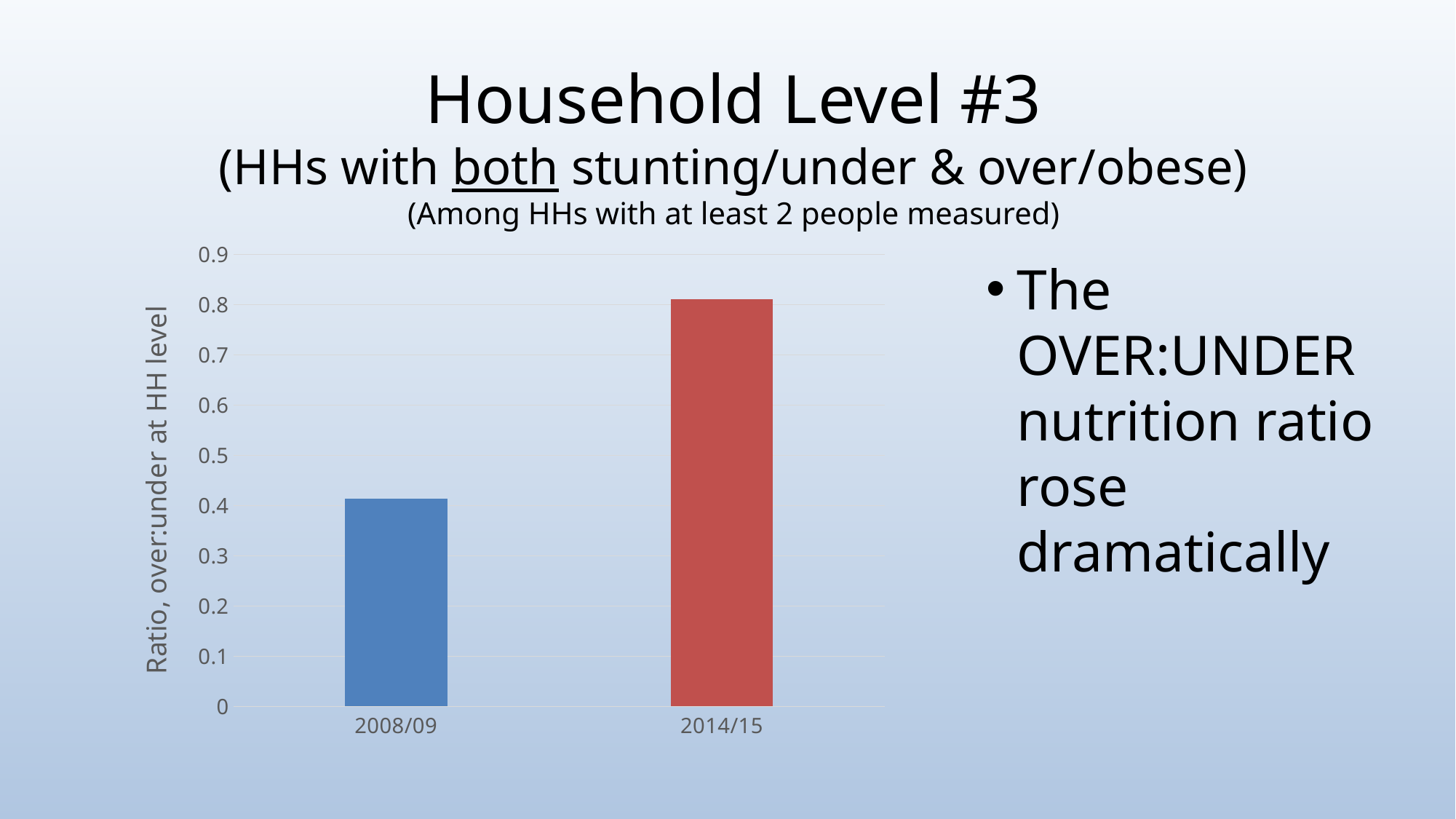
What colour is the bar for 2014/15? red Is the value for 2008/09 greater or less than 0.5? less Is the value for 2014/15 greater or less than 0.7? greater How many categories are plotted on the x axis of the chart? 2 What kind of chart is shown on the slide? bar chart Do the values rise or fall from 2008/09 to 2014/15? rise Is the value for 2014/15 greater or less than 0.9? less Which is larger, the value for 2008/09 or the value for 2014/15? 2014/15 What is the label on the vertical axis of the chart? Ratio, over:under at HH level Which category has the highest bar in the chart? 2014/15 Which category has the lowest bar in the chart? 2008/09